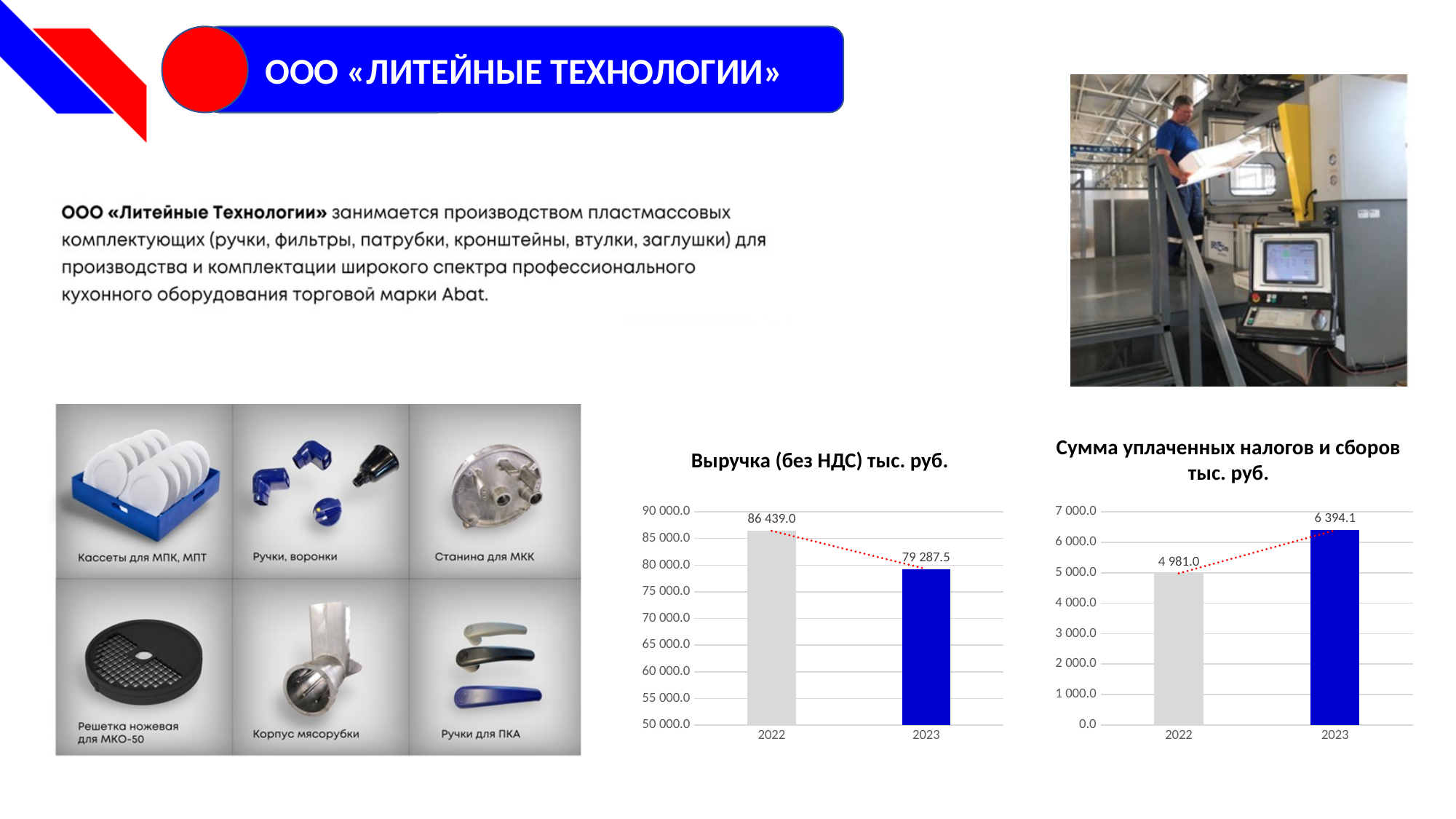
In the chart titled "Выручка (без НДС) тыс. руб.", do the values rise or fall from 2022 to 2023? fall In the chart titled "Выручка (без НДС) тыс. руб.", what is the value for 2022? 86 439.0 In the chart titled "Выручка (без НДС) тыс. руб.", what is the difference between the 2022 and 2023 values? 7 151.5 In the chart titled "Сумма уплаченных налогов и сборов тыс. руб.", which year has the lower value? 2022 In the chart titled "Сумма уплаченных налогов и сборов тыс. руб.", what is the value for 2023? 6 394.1 In the chart titled "Выручка (без НДС) тыс. руб.", which year has the higher value? 2022 In the chart titled "Сумма уплаченных налогов и сборов тыс. руб.", by how much did the value increase from 2022 to 2023? 1 413.1 In the chart titled "Сумма уплаченных налогов и сборов тыс. руб.", do the values rise or fall from 2022 to 2023? rise What kind of chart is the one titled "Выручка (без НДС) тыс. руб."? bar chart In the chart titled "Сумма уплаченных налогов и сборов тыс. руб.", what is the value for 2022? 4 981.0 In the chart titled "Выручка (без НДС) тыс. руб.", what is the value for 2023? 79 287.5 How many years are shown in the chart titled "Сумма уплаченных налогов и сборов тыс. руб."? 2